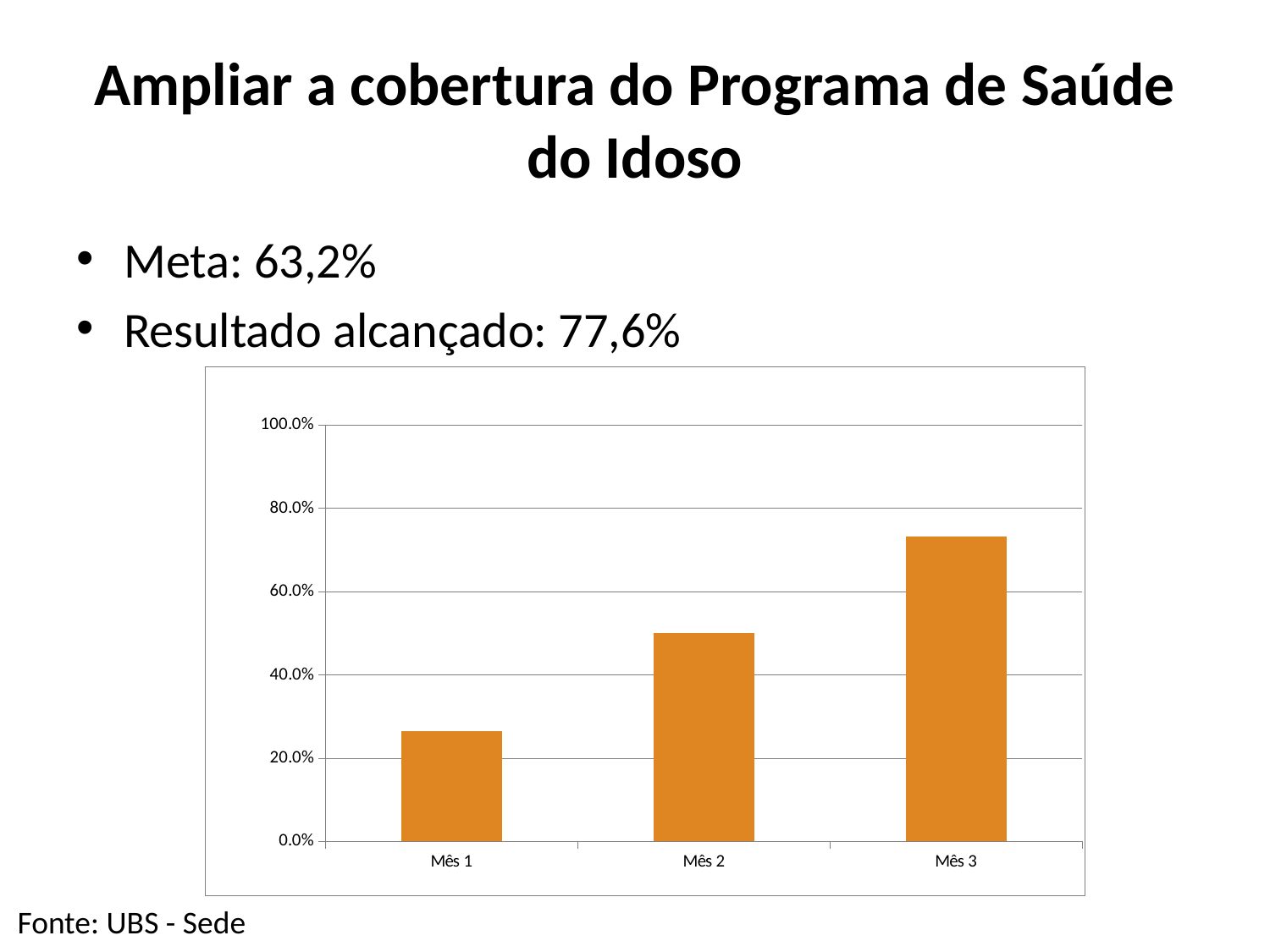
Which is larger, the value for Mês 2 or the value for Mês 1? Mês 2 Is the value for Mês 1 greater or less than 40.0%? less Do the values rise or fall from Mês 1 to Mês 3? Rise Is the value for Mês 3 greater or less than 80.0%? less How many categories are plotted on the x axis of the chart? 3 What kind of chart is shown on the slide? Bar chart Is the value for Mês 3 greater or less than 60.0%? greater Which is larger, the value for Mês 1 or the value for Mês 3? Mês 3 Which month has the lowest bar in the chart? Mês 1 Which month has the highest bar in the chart? Mês 3 What colour are the bars in the chart? Orange